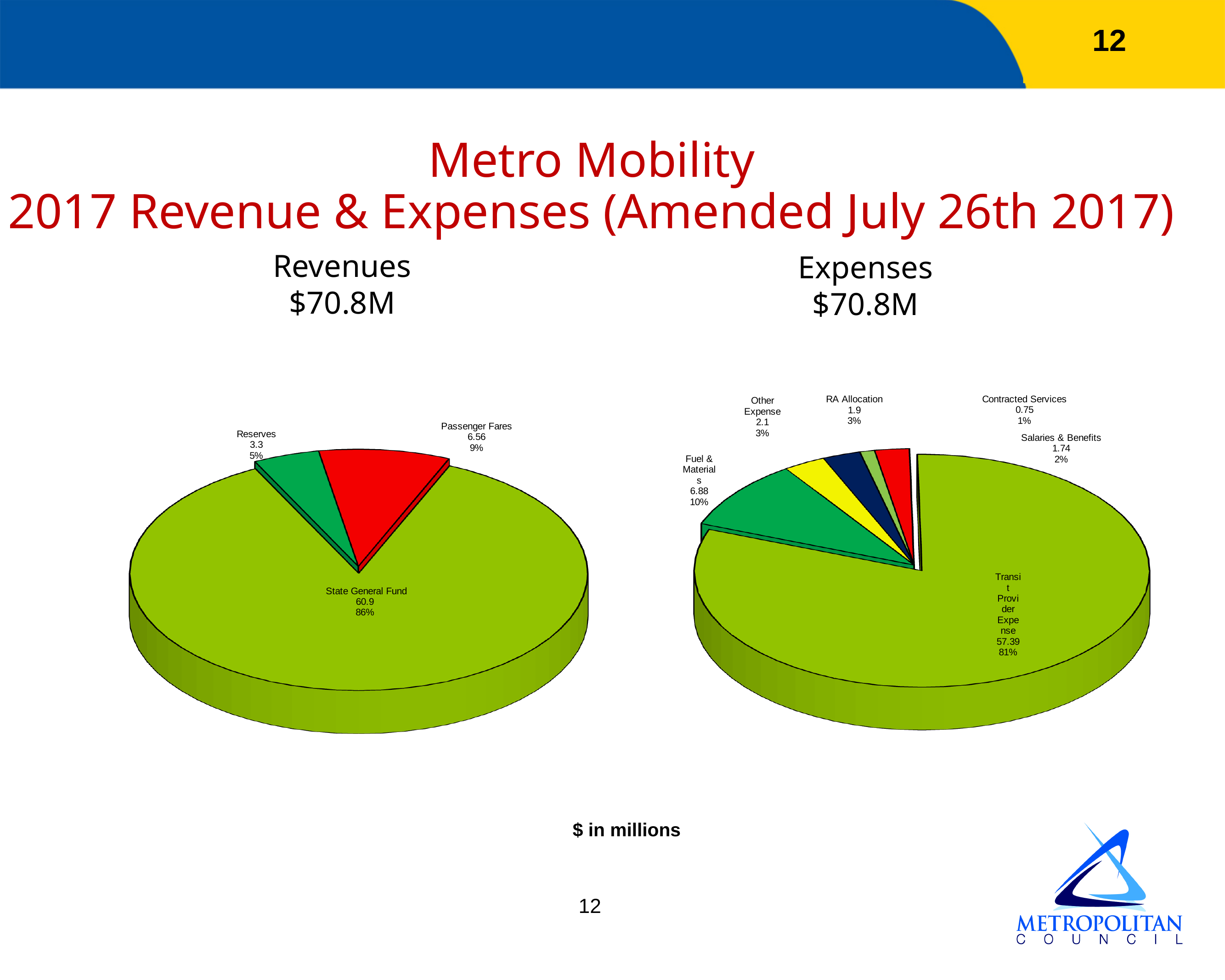
How many categories are in the Revenues chart? 3 In the Expenses chart, what is the value for Fuel & Materials? 6.88 In the Revenues chart, what is the value for State General Fund? 60.9 In the Expenses chart, which is larger, Other Expense or RA Allocation? Other Expense In the Expenses chart, which category is the smallest? Contracted Services How many categories are in the Expenses chart? 6 In the Expenses chart, what share of the pie is Salaries & Benefits? 2% In the Revenues chart, what is the difference between Passenger Fares and Reserves? 3.26 In the Revenues chart, what share of the pie is Passenger Fares? 9% In the Revenues chart, which category is the smallest? Reserves In the Expenses chart, which category is the largest? Transit Provider Expense What kind of chart is the Revenues chart? Pie chart